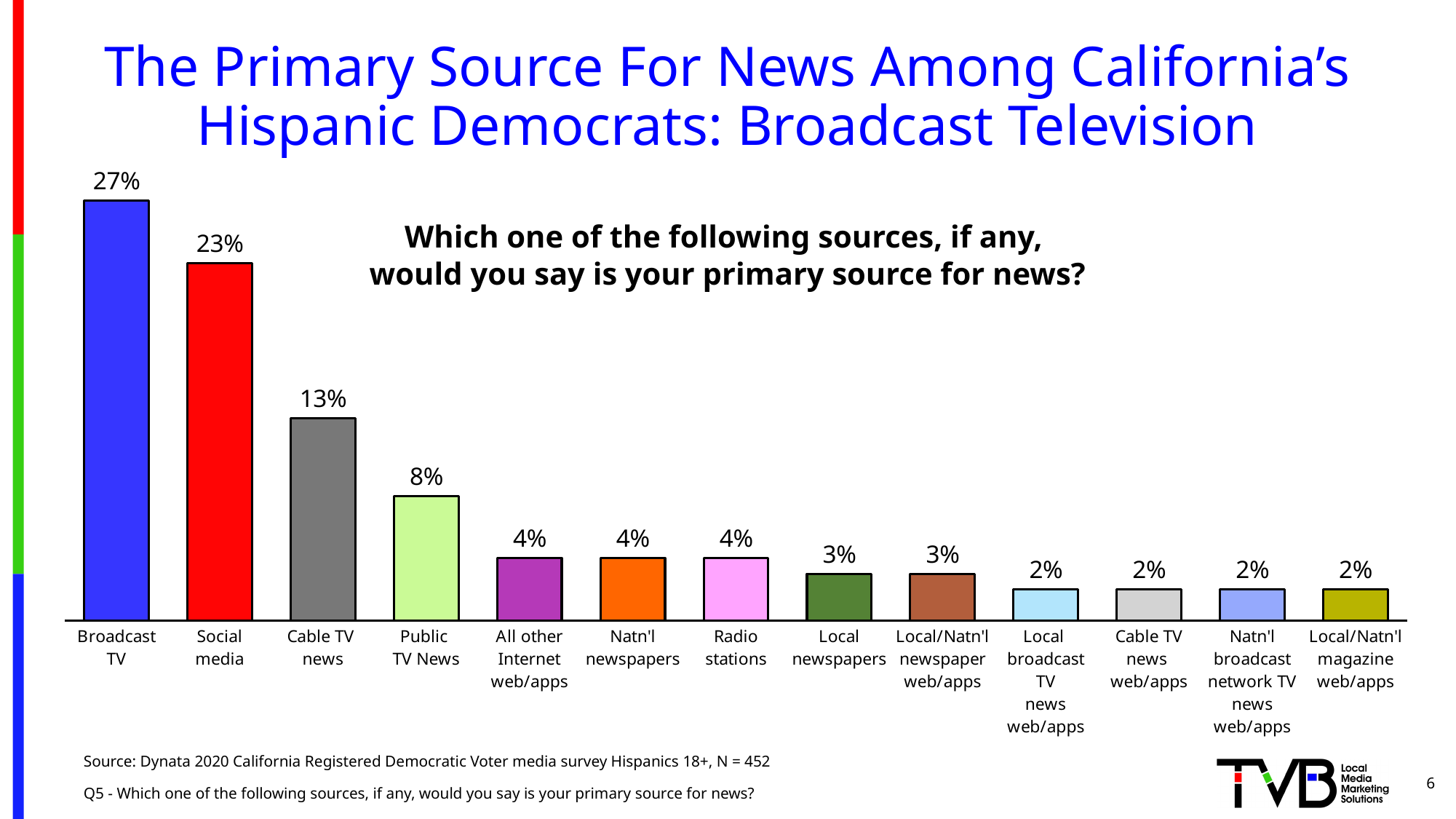
Which is larger, the value for Radio stations or the value for Local newspapers? Radio stations What kind of chart is shown on the slide? Bar chart How many sources (categories) are shown on the chart? 13 What is the value shown for Cable TV news? 13% Do the values rise or fall moving from left to right along the x axis? Fall What percentage of California's Hispanic Democrats name Broadcast TV as their primary source for news? 27% Which source has the highest value on the chart? Broadcast TV What is the value shown for Social media? 23% What is the difference between the values for Broadcast TV and Social media? 4% What is the difference between the values for Cable TV news and Public TV News? 5% What is the value shown for Public TV News? 8% What colour is the bar for Social media? Red